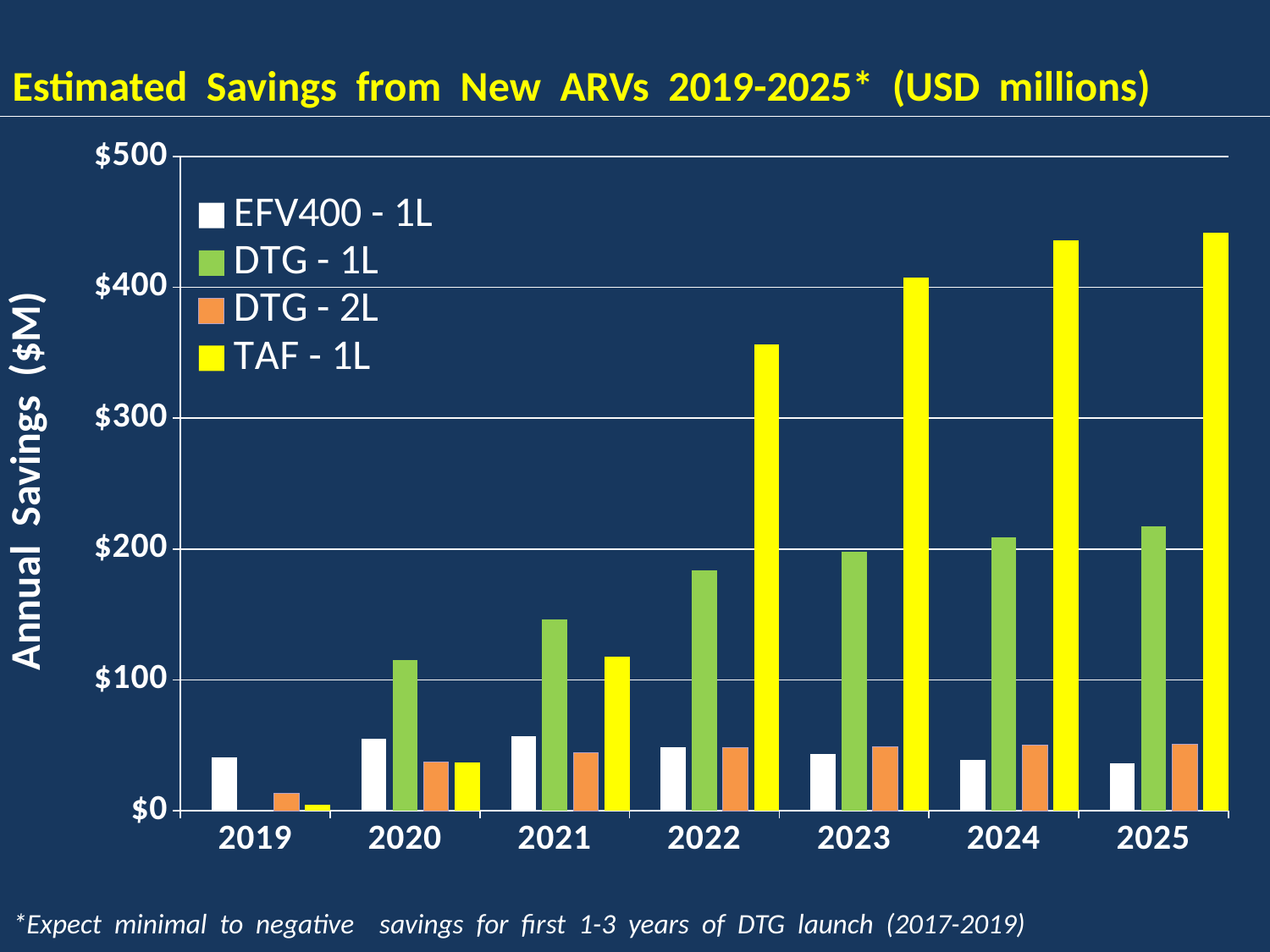
Which year has the lowest value for TAF - 1L? 2019 In 2021, which is larger: DTG - 1L or TAF - 1L? DTG - 1L Do the values for DTG - 1L rise or fall from 2020 to 2025? rise Is the value for DTG - 1L in 2021 greater or less than $100? greater Is the value for TAF - 1L in 2022 greater or less than $300? greater In 2022, which is larger: TAF - 1L or DTG - 1L? TAF - 1L Is the value for TAF - 1L in 2020 greater or less than $100? less What type of chart is shown on the slide? bar chart Which series has the tallest bar in 2025? TAF - 1L How many years are shown on the x axis? 7 How many series does the legend list? 4